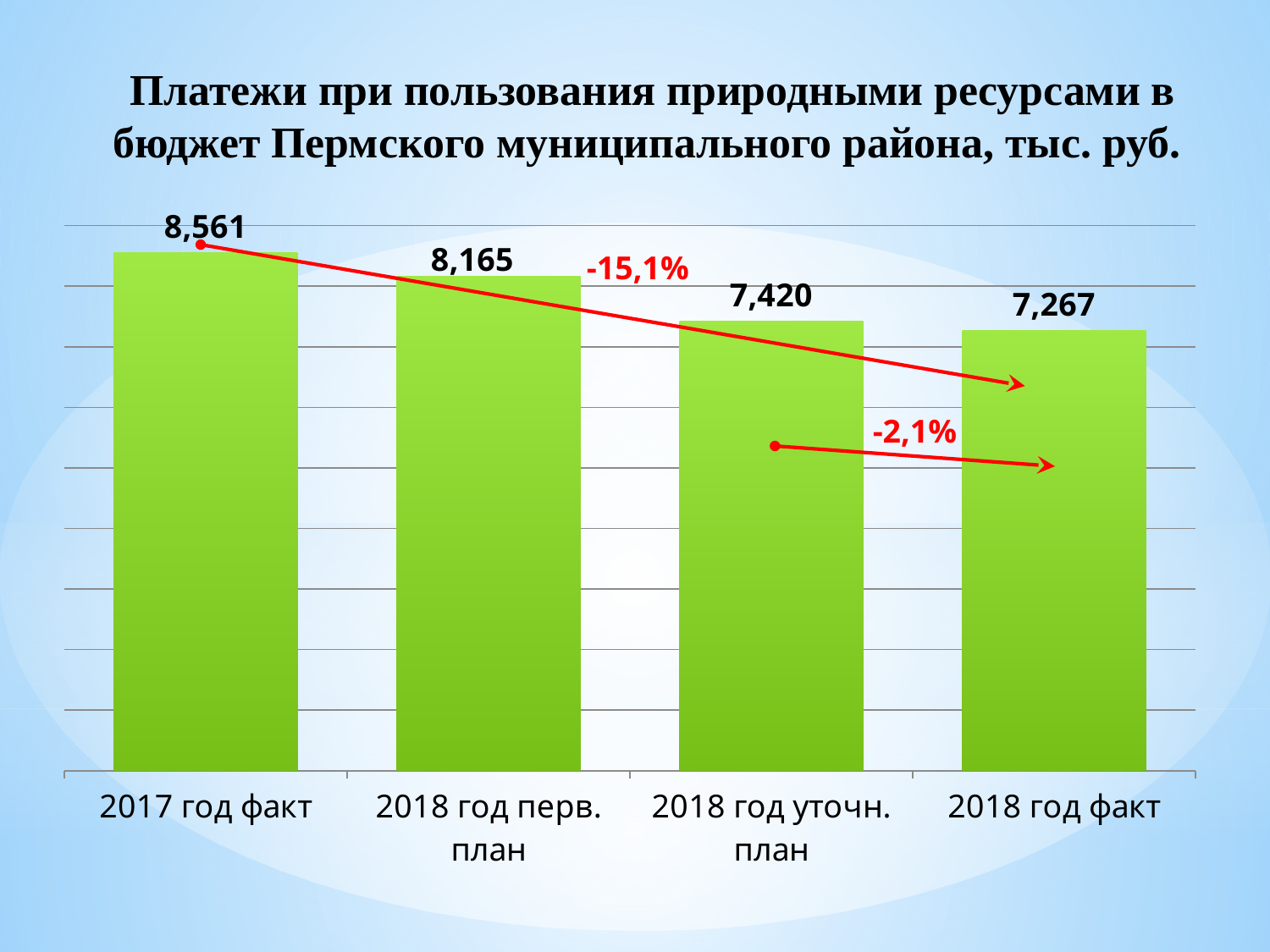
Which is larger, the value for "2018 год перв. план" or the value for "2018 год уточн. план"? 2018 год перв. план How many categories are shown on the x axis? 4 What kind of chart is shown on the slide? Bar chart Which category has the lowest value? 2018 год факт What is the value for "2018 год перв. план"? 8,165 Which category has the highest value? 2017 год факт What is the difference between the values for "2018 год перв. план" and "2018 год уточн. план"? 745 What is the difference between the values for "2017 год факт" and "2018 год факт"? 1,294 What is the value for "2017 год факт"? 8,561 What is the value for "2018 год факт"? 7,267 What is the value for "2018 год уточн. план"? 7,420 Do the values rise or fall from left to right along the x axis? Fall